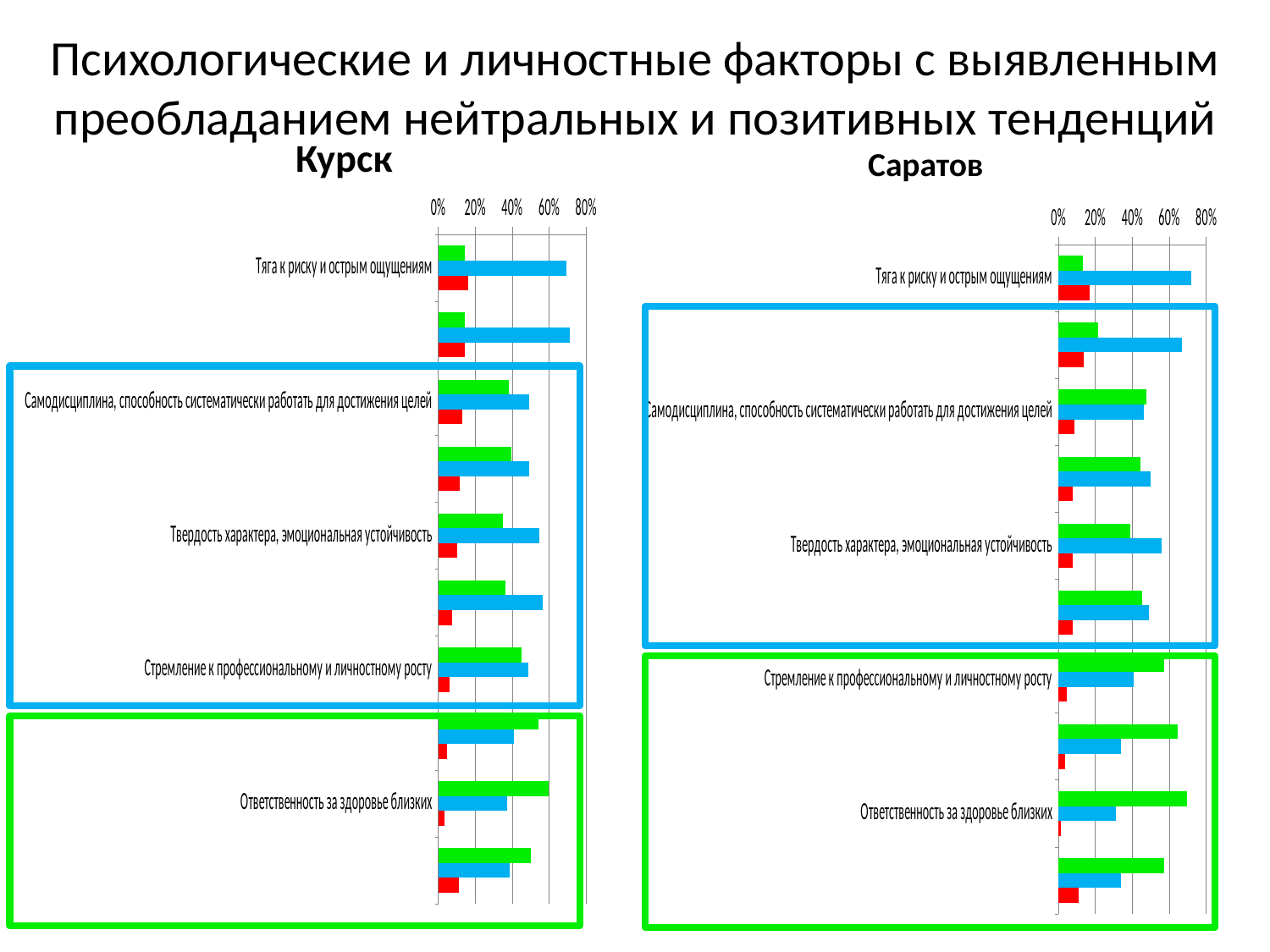
In the Саратов chart, is the green bar for 'Ответственность за здоровье близких' greater or less than 60%? greater What is the title of the chart on the right side of the slide? Саратов In the Курск chart, is the red bar for 'Стремление к профессиональному и личностному росту' greater or less than 20%? less In the Саратов chart, for 'Ответственность за здоровье близких', which bar is longer, the green one or the blue one? the green one In the Курск chart, is the blue bar for 'Тяга к риску и острым ощущениям' greater or less than 60%? greater In the Курск chart, for 'Тяга к риску и острым ощущениям', which bar is longer, the blue one or the green one? the blue one What kind of chart is the Курск chart? bar chart